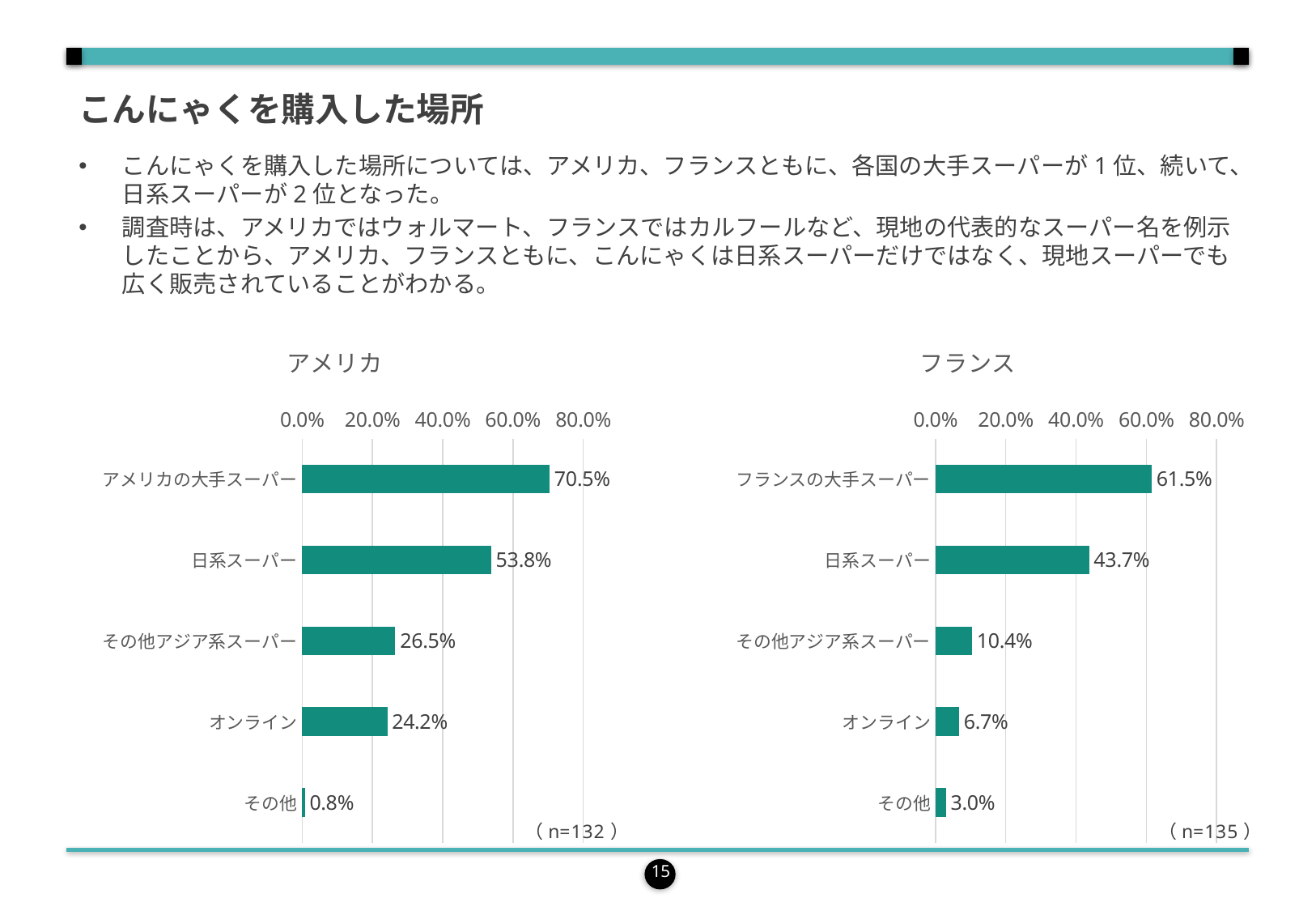
What kind of chart is the フランス chart? bar chart In the アメリカ chart, what is the difference between アメリカの大手スーパー and 日系スーパー? 16.7% What is the sample size (n) shown for the アメリカ chart? n=132 In the フランス chart, what is the value for その他アジア系スーパー? 10.4% In the フランス chart, what is the value for オンライン? 6.7% In the アメリカ chart, what is the value for 日系スーパー? 53.8% In the フランス chart, which category has the lowest value? その他 How many categories are shown in the アメリカ chart? 5 Which is larger: 日系スーパー in the アメリカ chart or 日系スーパー in the フランス chart? アメリカ In the フランス chart, is the value for フランスの大手スーパー greater or less than 40.0%? greater In the アメリカ chart, which category has the highest value? アメリカの大手スーパー In the フランス chart, what is the difference between その他アジア系スーパー and オンライン? 3.7%